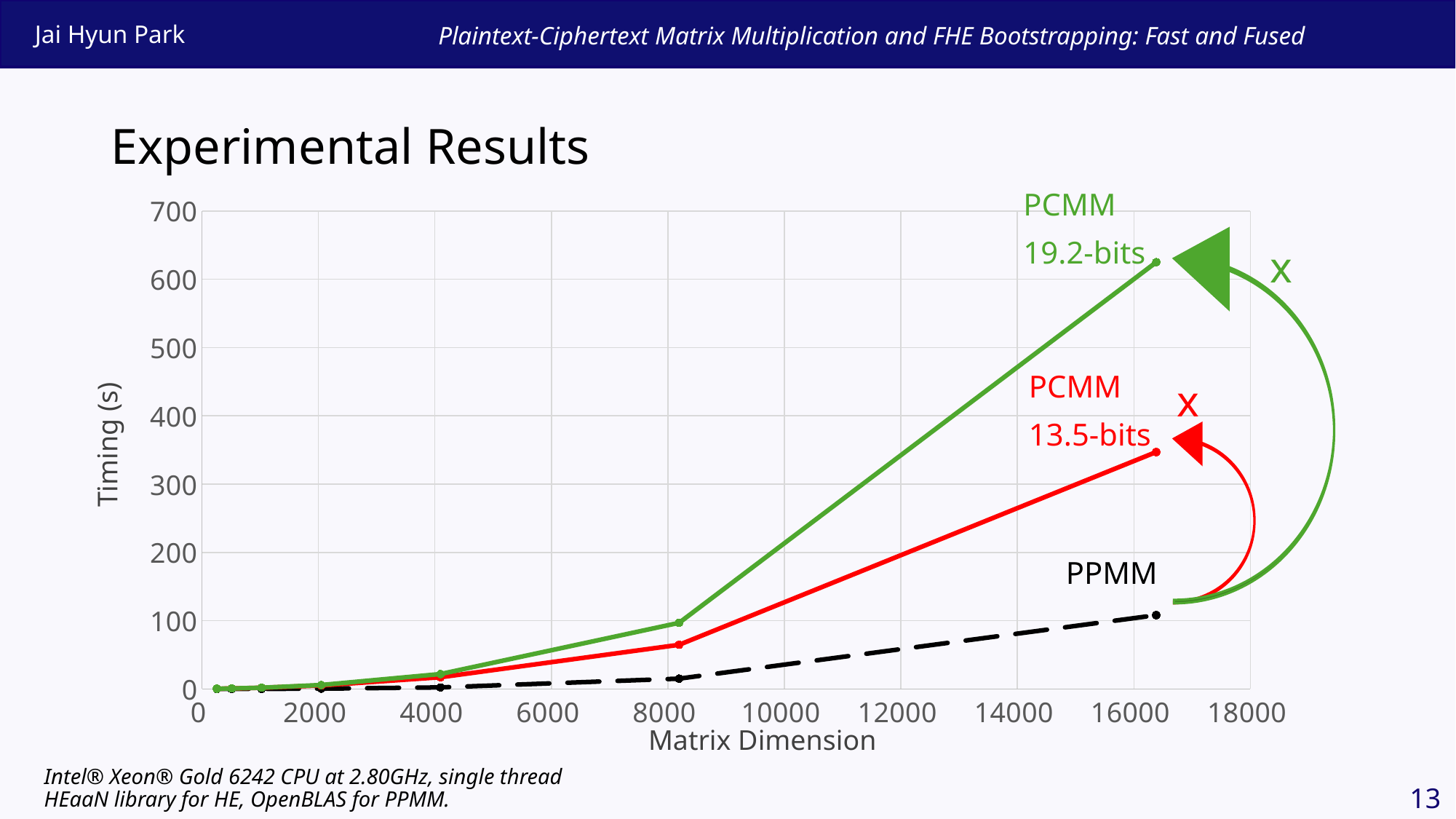
What is the label of the x axis? Matrix Dimension At the largest matrix dimension, is the timing for PPMM greater or less than 200? less At a matrix dimension of about 8000, is the timing for PCMM 13.5-bits greater or less than 100? less At the largest matrix dimension, is the timing for PCMM 13.5-bits greater or less than 400? less At the largest matrix dimension, which has the larger timing: PCMM 13.5-bits or PPMM? PCMM 13.5-bits What kind of chart is shown on the slide? line chart How many series are plotted on the chart? 3 Does the timing for PCMM 19.2-bits rise or fall as the matrix dimension increases? rise Which series has the highest timing at the largest matrix dimension? PCMM 19.2-bits Which series has the lowest timing at the largest matrix dimension? PPMM What is the label of the y axis? Timing (s)